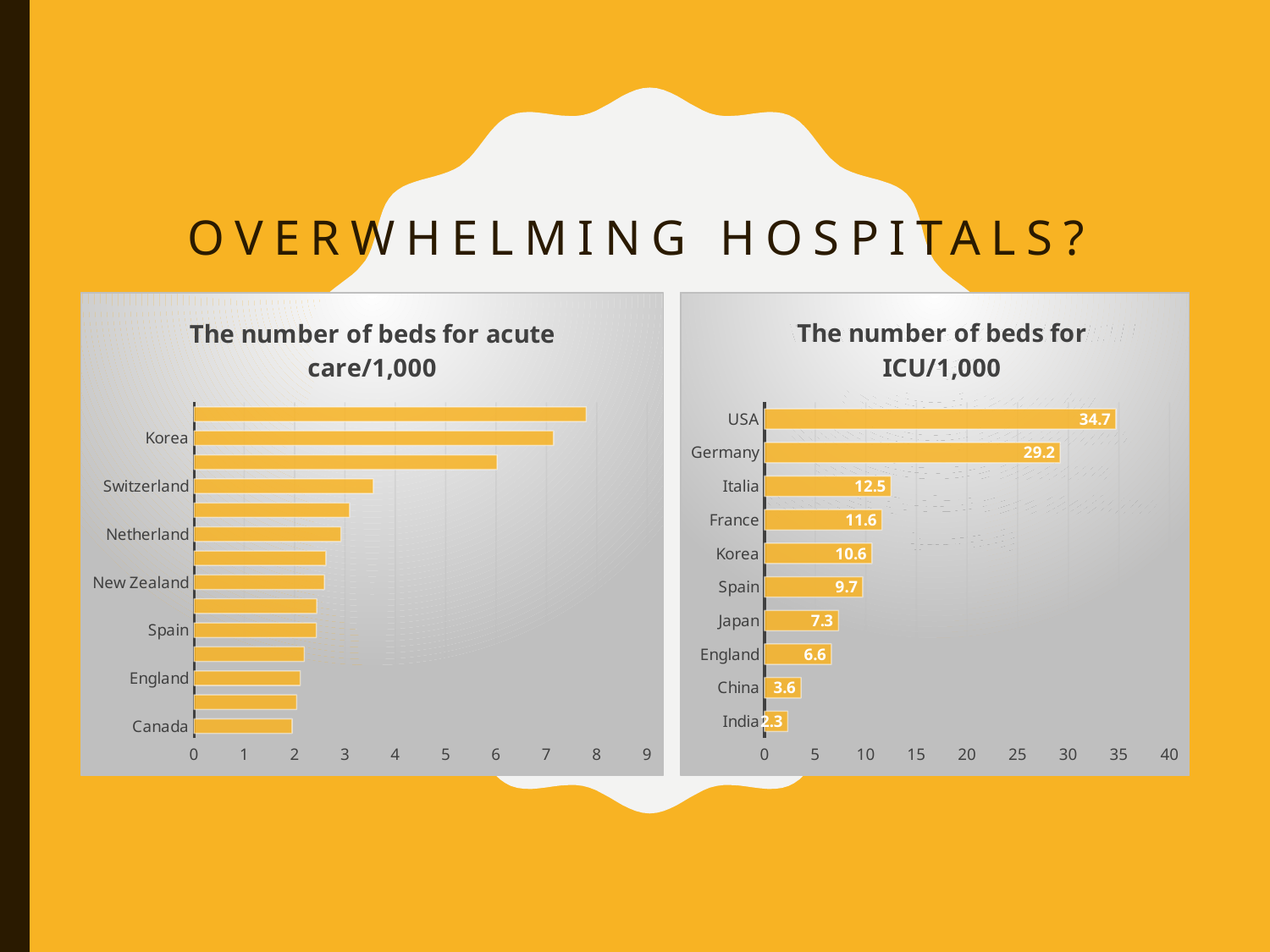
In the chart titled "The number of beds for ICU/1,000", what is the value for Germany? 29.2 In the chart titled "The number of beds for ICU/1,000", how many countries are shown? 10 In the chart titled "The number of beds for acute care/1,000", how many bars are plotted? 14 What kind of chart is the chart titled "The number of beds for ICU/1,000"? Bar chart In the chart titled "The number of beds for acute care/1,000", is the value for Switzerland greater or less than 3? greater In the chart titled "The number of beds for ICU/1,000", which country has the highest value? USA In the chart titled "The number of beds for ICU/1,000", what is the value for Japan? 7.3 In the chart titled "The number of beds for acute care/1,000", is the value for Canada greater or less than 3? less In the chart titled "The number of beds for ICU/1,000", which country has the lowest value? India In the chart titled "The number of beds for ICU/1,000", which is larger, the value for France or the value for Korea? France In the chart titled "The number of beds for ICU/1,000", what is the difference between the values for USA and Germany? 5.5 In the chart titled "The number of beds for acute care/1,000", is the value for Korea greater or less than 6? greater